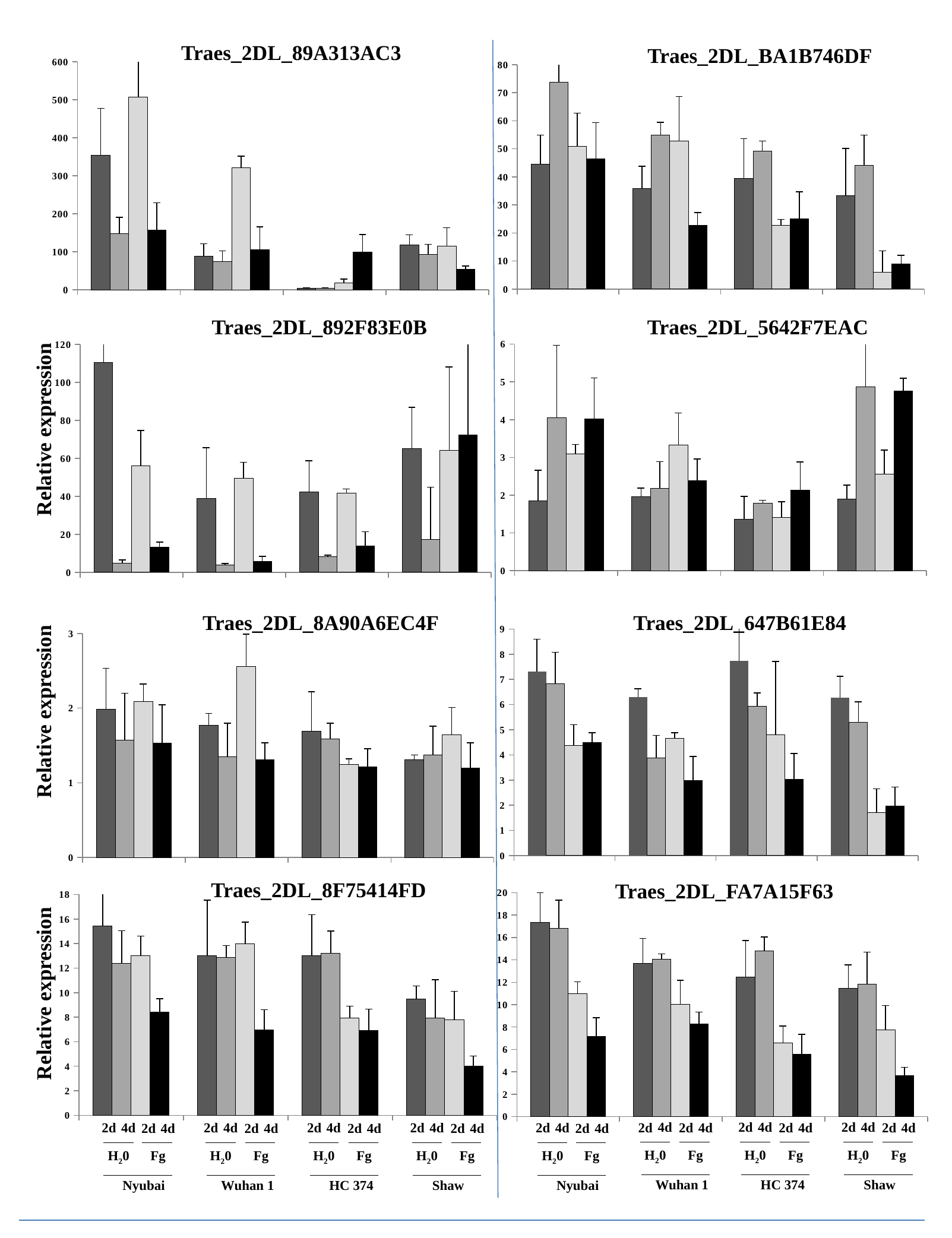
In the Traes_2DL_89A313AC3 chart, which cultivar and treatment has the tallest bar? Nyubai, Fg 2d In the Traes_2DL_89A313AC3 chart, is the value for Nyubai Fg 2d greater or less than 400? greater In the Traes_2DL_89A313AC3 chart, is the value for HC 374 H2O 2d greater or less than 100? less How many cultivars are shown along the x axis of the Traes_2DL_8F75414FD chart? 4 In the Traes_2DL_647B61E84 chart, is the value for HC 374 H2O 2d greater or less than 7? greater What is the y-axis label on the Traes_2DL_8A90A6EC4F chart? Relative expression What kind of chart is Traes_2DL_89A313AC3? bar chart How many charts are shown on the slide? 8 In the Traes_2DL_892F83E0B chart, which cultivar and treatment has the tallest bar? Nyubai, H2O 2d